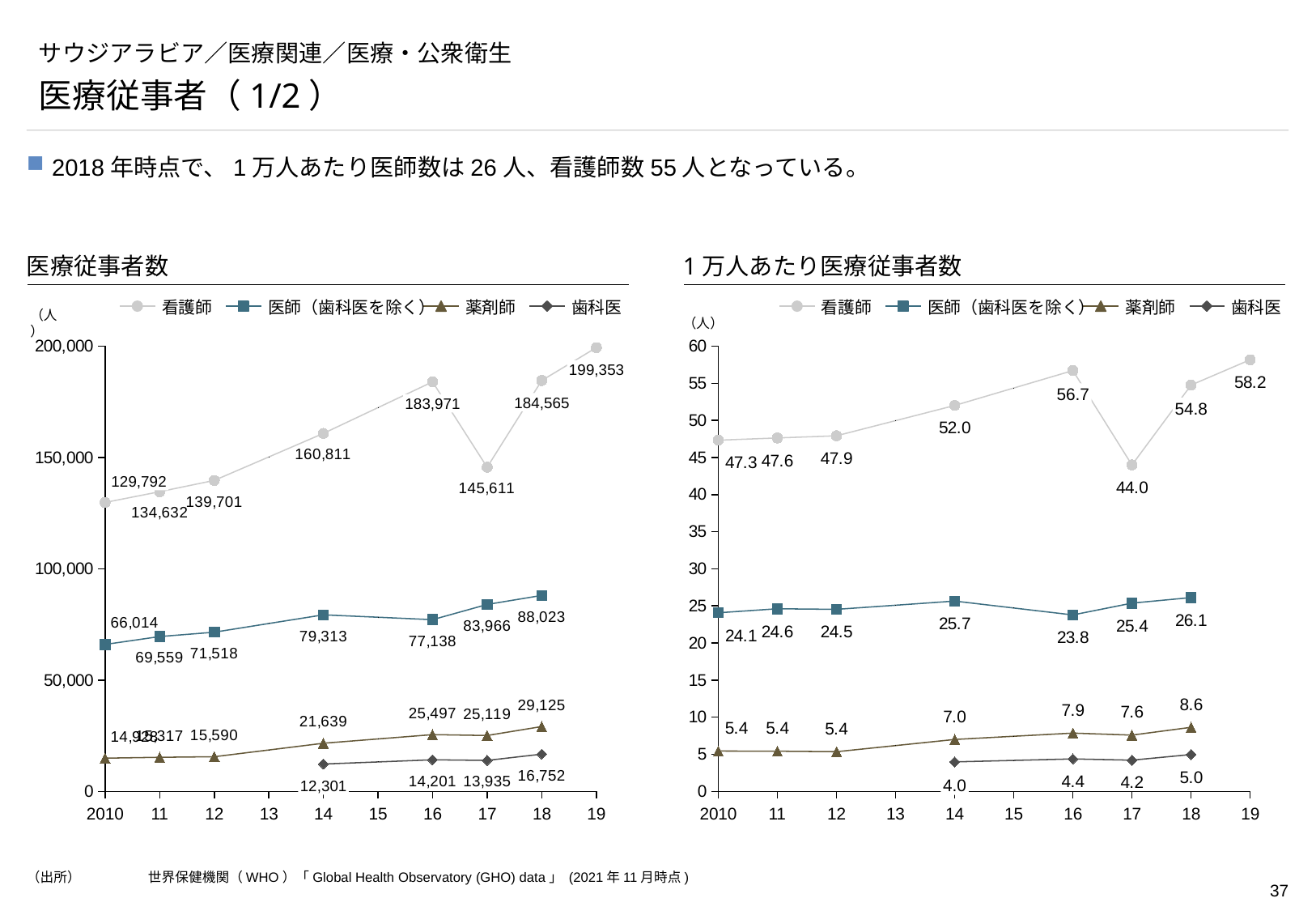
In the right chart (1万人あたり医療従事者数), which is larger, the 医師（歯科医を除く） value in 2018 or in 2016? 2018 In the right chart (1万人あたり医療従事者数), what is the difference between the 歯科医 values for 2018 and 2014? 1.0 In the left chart (医療従事者数), what is the value for 看護師 in 2019? 199,353 In the left chart (医療従事者数), what is the value for 歯科医 in 2014? 12,301 In the right chart (1万人あたり医療従事者数), what is the value for 薬剤師 in 2018? 8.6 In the right chart (1万人あたり医療従事者数), what is the value for 看護師 in 2017? 44.0 How many series does the legend of the left chart (医療従事者数) list? 4 In the left chart (医療従事者数), in which year is the 看護師 value lowest? 2010 What type of chart is the right chart (1万人あたり医療従事者数)? Line chart In the right chart (1万人あたり医療従事者数), in which year is the 看護師 value highest? 2019 In the left chart (医療従事者数), what is the value for 医師（歯科医を除く） in 2018? 88,023 In the left chart (医療従事者数), what is the difference between the 看護師 values for 2018 and 2017? 38,954